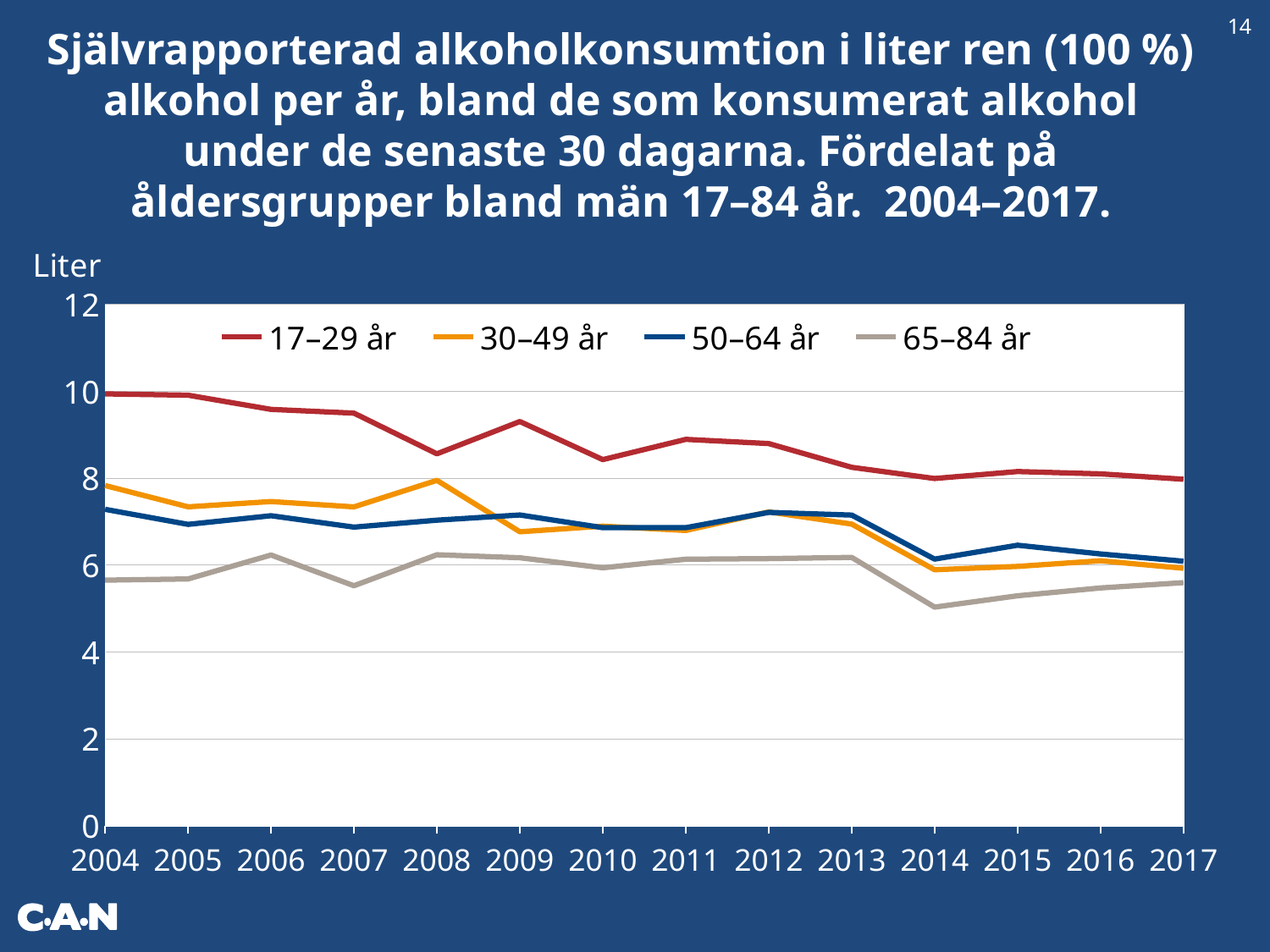
What kind of chart is shown on the slide? line chart Which colour is used for the 65–84 år series? grey Which age group has the highest value in 2004? 17–29 år Which is larger in 2008: the value for 30–49 år or the value for 50–64 år? 30–49 år Does the value for 17–29 år generally rise or fall from 2004 to 2017? fall What is the label on the y axis? Liter Is the value for 30–49 år in 2008 greater or less than 6? greater How many years are shown on the x axis? 14 Is the value for 65–84 år in 2014 greater or less than 6? less Which age group has the lowest value in 2014? 65–84 år How many series does the legend list? 4 Is the value for 17–29 år in 2017 greater or less than 6? greater